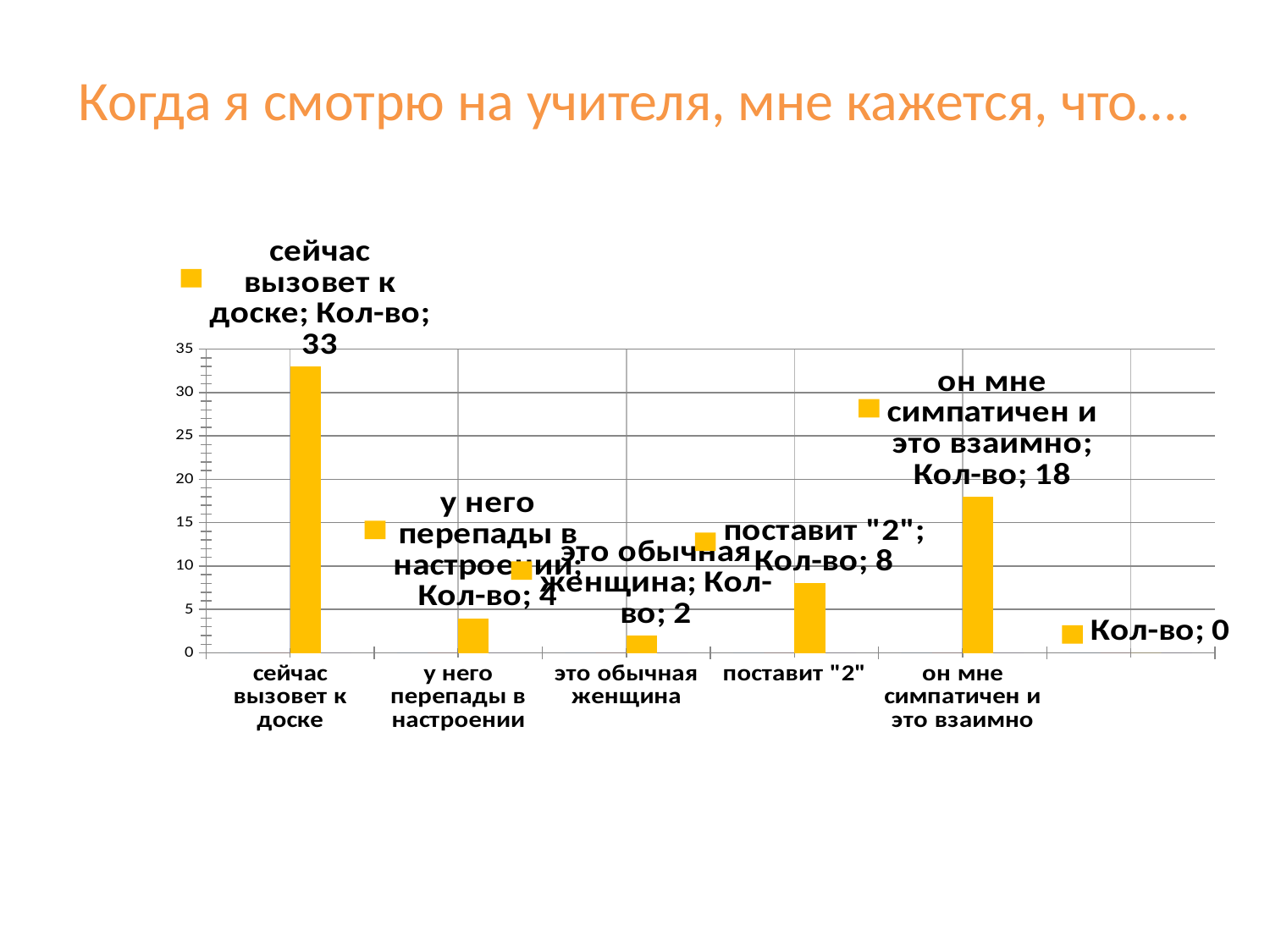
Which labeled category has the highest value? сейчас вызовет к доске What is the difference between the values for "сейчас вызовет к доске" and "он мне симпатичен и это взаимно"? 15 What is the value for "это обычная женщина"? 2 What is the value for "у него перепады в настроении"? 4 What is the value for "он мне симпатичен и это взаимно"? 18 What kind of chart is shown on the slide? bar chart What is the value for "сейчас вызовет к доске"? 33 Is the value for "он мне симпатичен и это взаимно" greater or less than 20? less Which is larger: the value for "поставит "2"" or the value for "у него перепады в настроении"? поставит "2" What is the title of the chart? Когда я смотрю на учителя, мне кажется, что…. Which labeled category has the lowest value? это обычная женщина What is the value for "поставит "2""? 8